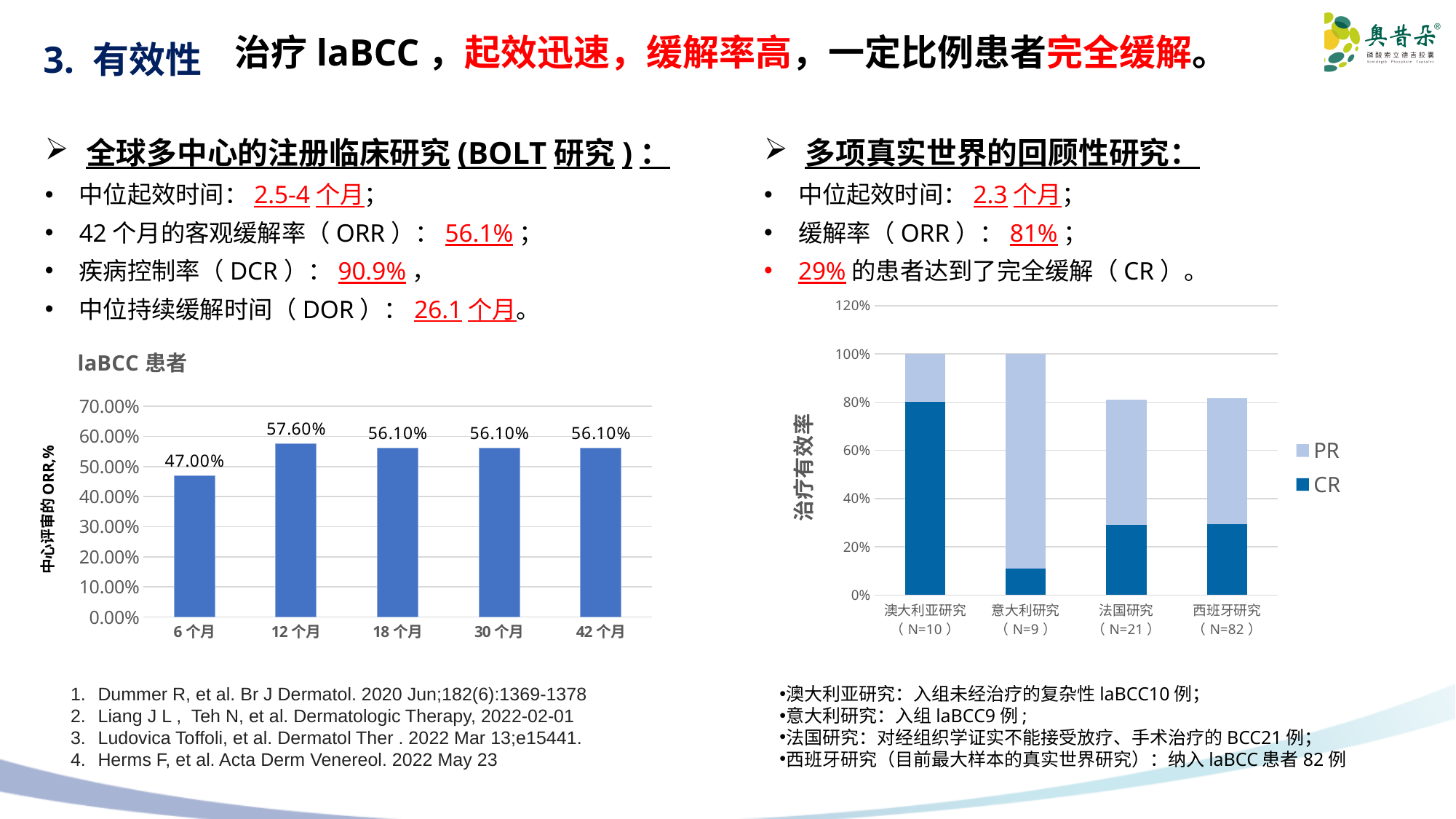
In the left chart titled laBCC 患者, which time point has the highest value? 12 个月 In the right stacked bar chart, is the CR value for 澳大利亚研究 (N=10) greater or less than 60%? greater What kind of chart is the left chart titled laBCC 患者? bar chart In the left chart titled laBCC 患者, what is the difference between the values for 12 个月 and 6 个月? 10.60% In the right stacked bar chart, which study has the larger CR segment, 澳大利亚研究 (N=10) or 法国研究 (N=21)? 澳大利亚研究 (N=10) In the left chart titled laBCC 患者, how many time points are plotted? 5 In the left chart titled laBCC 患者, which time point has the lowest value? 6 个月 In the left chart titled laBCC 患者, what is the value for 6 个月? 47.00% In the left chart titled laBCC 患者, what is the value for 42 个月? 56.10% In the right stacked bar chart, how many series does the legend list? 2 In the right stacked bar chart, is the CR value for 意大利研究 (N=9) greater or less than 20%? less In the left chart titled laBCC 患者, what is the value for 12 个月? 57.60%